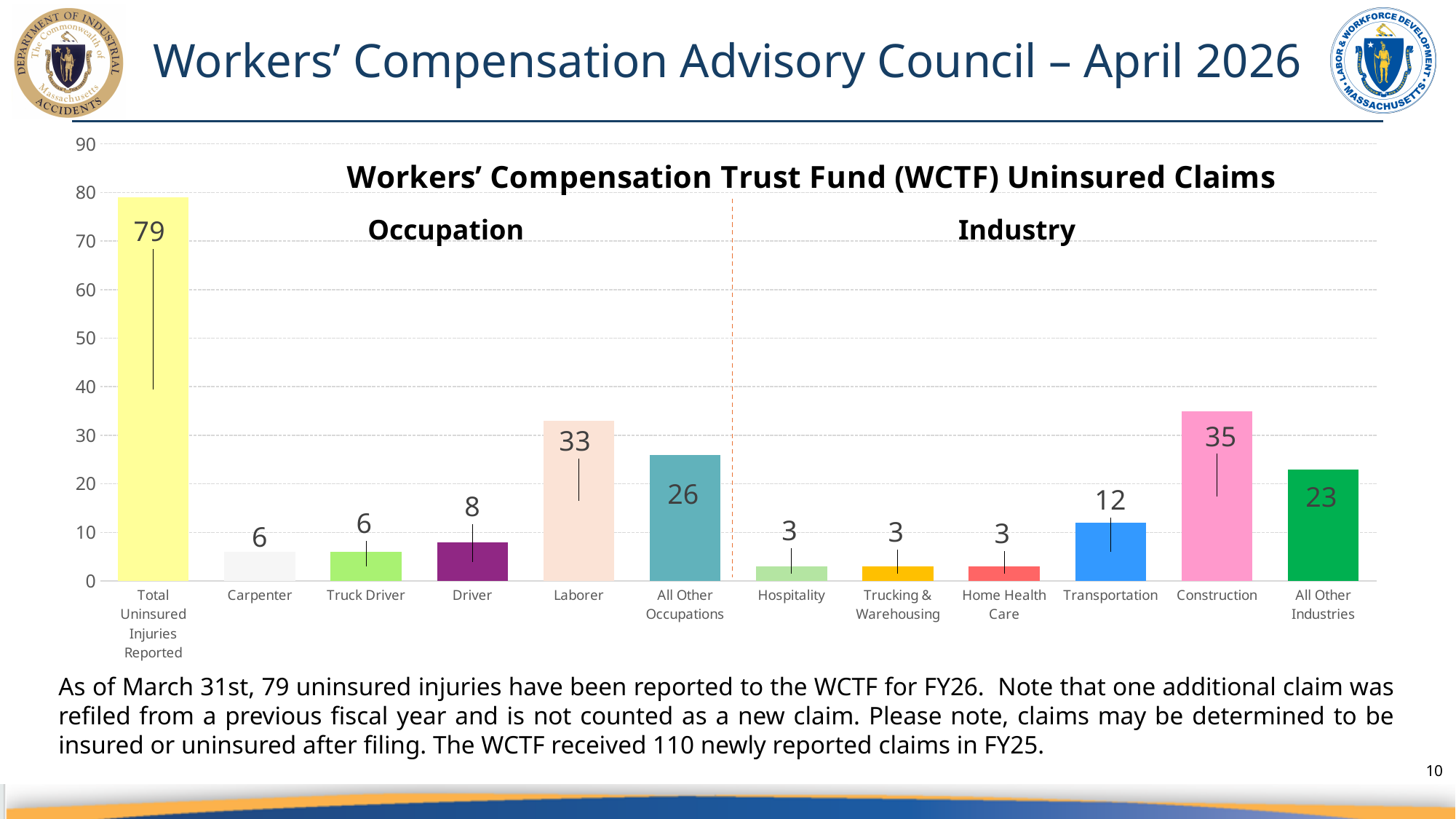
What is the title of the chart? Workers' Compensation Trust Fund (WCTF) Uninsured Claims What kind of chart is shown on the slide? Bar chart Which is larger, the value for Driver or the value for Transportation? Transportation What is the value for Transportation? 12 What is the value for All Other Industries? 23 Among the Industry categories, which has the highest value? Construction How many categories are shown on the x axis? 12 What is the value for Construction? 35 What is the difference between the values for Construction and Laborer? 2 What is the difference between the values for All Other Occupations and All Other Industries? 3 What is the value for Laborer? 33 Which category has the highest value? Total Uninsured Injuries Reported